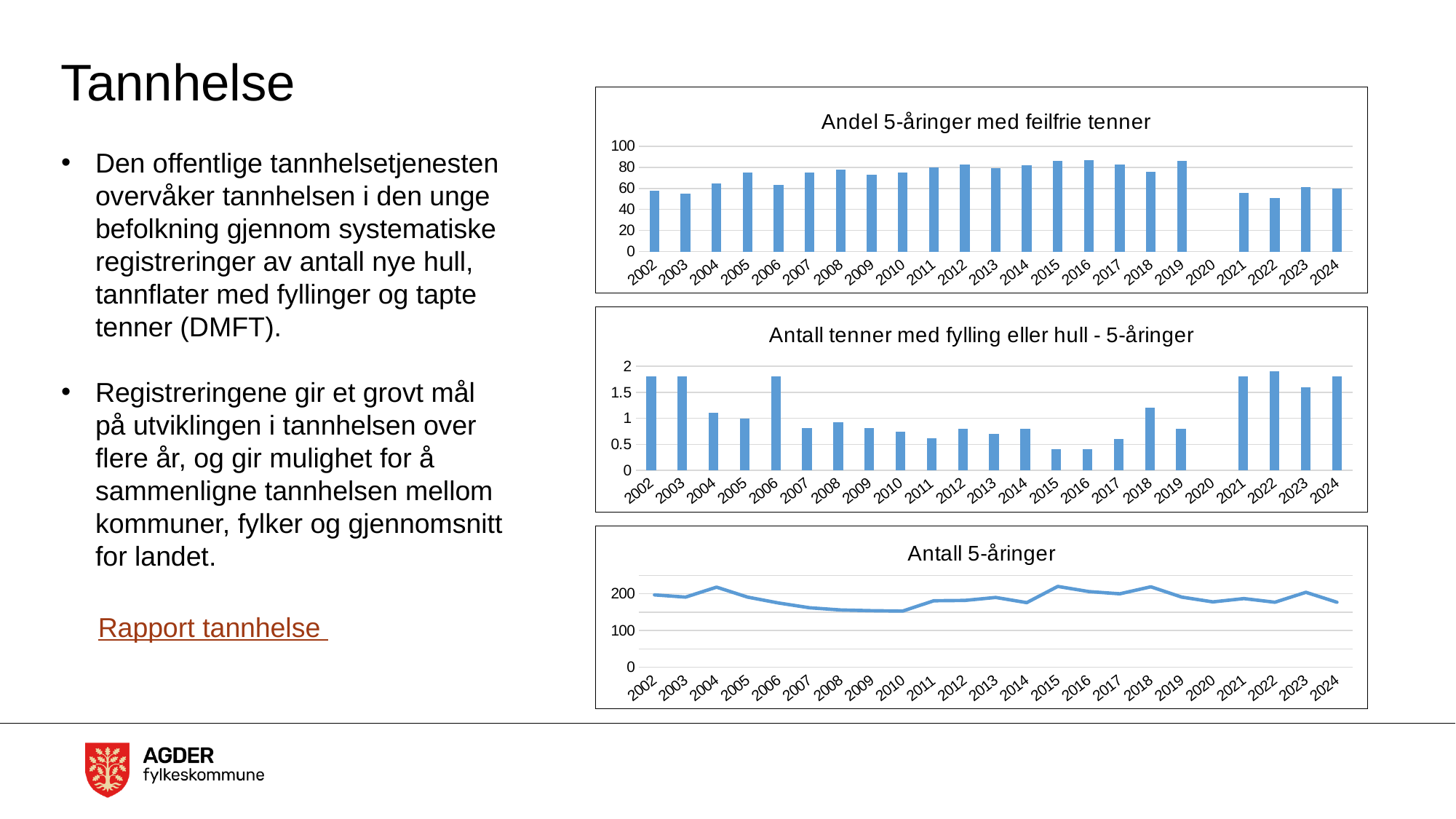
In the chart "Antall tenner med fylling eller hull - 5-åringer", is the value for 2015 greater or less than 0.5? less In the chart "Antall tenner med fylling eller hull - 5-åringer", is the value for 2006 larger or smaller than the value for 2007? larger In the chart "Andel 5-åringer med feilfrie tenner", which year has no bar shown? 2020 In the chart "Antall 5-åringer", is the value for 2009 greater or less than 200? less In the chart "Andel 5-åringer med feilfrie tenner", is the value for 2022 greater or less than 60? less In the chart "Antall tenner med fylling eller hull - 5-åringer", do the values generally rise or fall from 2006 to 2016? fall What kind of chart is "Antall 5-åringer"? line chart What kind of chart is "Andel 5-åringer med feilfrie tenner"? bar chart How many years are shown on the x axis of the chart "Antall 5-åringer"? 23